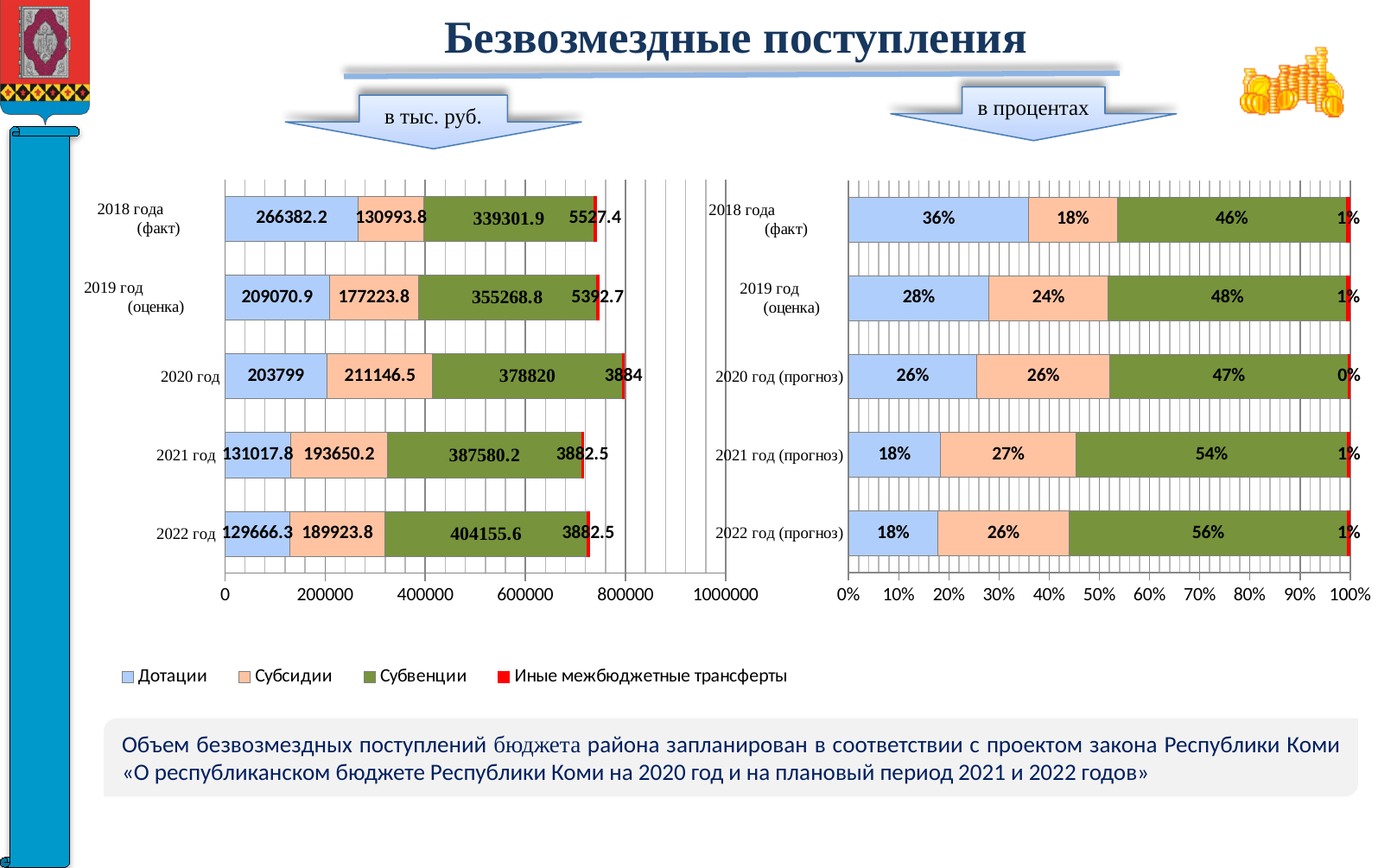
On the left chart (в тыс. руб.), what is the total of the stacked bar for 2018 года (факт)? 742205.3 What type of chart is the right chart (в процентах)? Stacked bar chart On the left chart (в тыс. руб.), which year has the highest value for Субвенции? 2022 год On the left chart (в тыс. руб.), which is larger for 2019 год (оценка): Дотации or Субсидии? Дотации On the left chart (в тыс. руб.), what is the difference between Субсидии in 2020 год and Субсидии in 2018 года (факт)? 80152.7 On the left chart (в тыс. руб.), what is the value of Дотации for 2018 года (факт)? 266382.2 How many series does the legend list? 4 On the right chart (в процентах), what share do Субсидии make up in 2019 год (оценка)? 24% On the right chart (в процентах), does the share of Дотации rise or fall from 2018 года (факт) to 2022 год (прогноз)? Fall On the left chart (в тыс. руб.), which year has the lowest value for Дотации? 2022 год On the left chart (в тыс. руб.), what is the value of Субвенции for 2022 год? 404155.6 On the right chart (в процентах), what share do Субвенции make up in 2021 год (прогноз)? 54%